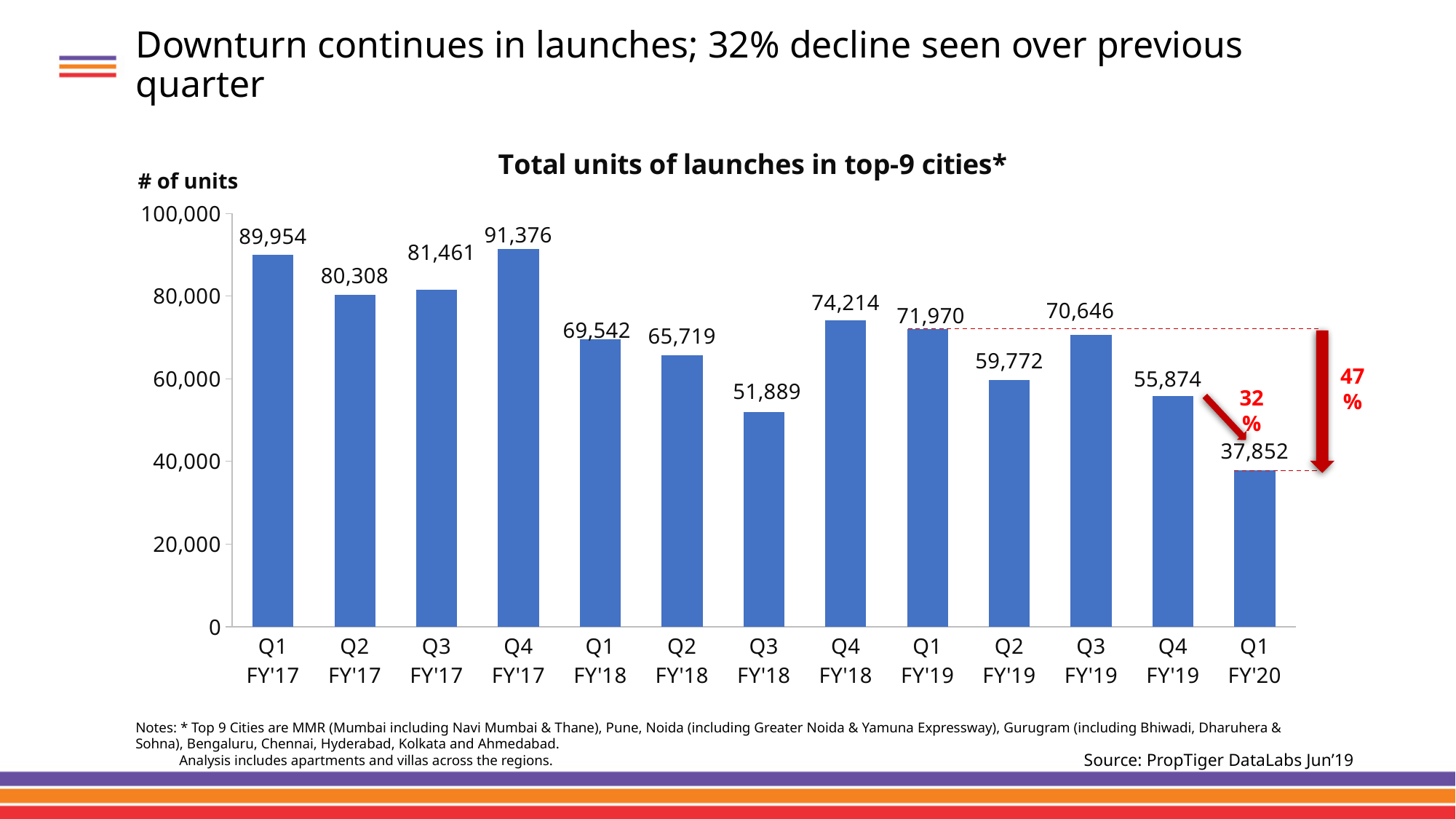
What is the value for Q4 FY'19? 55,874 What is the difference between the values for Q4 FY'19 and Q1 FY'20? 18,022 Which is larger, the value for Q4 FY'18 or the value for Q1 FY'19? Q4 FY'18 How many quarters are shown on the x axis? 13 What is the value for Q1 FY'20? 37,852 What is the title of the chart? Total units of launches in top-9 cities* What kind of chart is shown on the slide? bar chart What is the difference between the values for Q1 FY'19 and Q1 FY'20? 34,118 What is the value for Q3 FY'18? 51,889 Which quarter has the lowest number of units launched? Q1 FY'20 Is the value for Q3 FY'18 greater or less than 60,000? less Which quarter has the highest number of units launched? Q4 FY'17